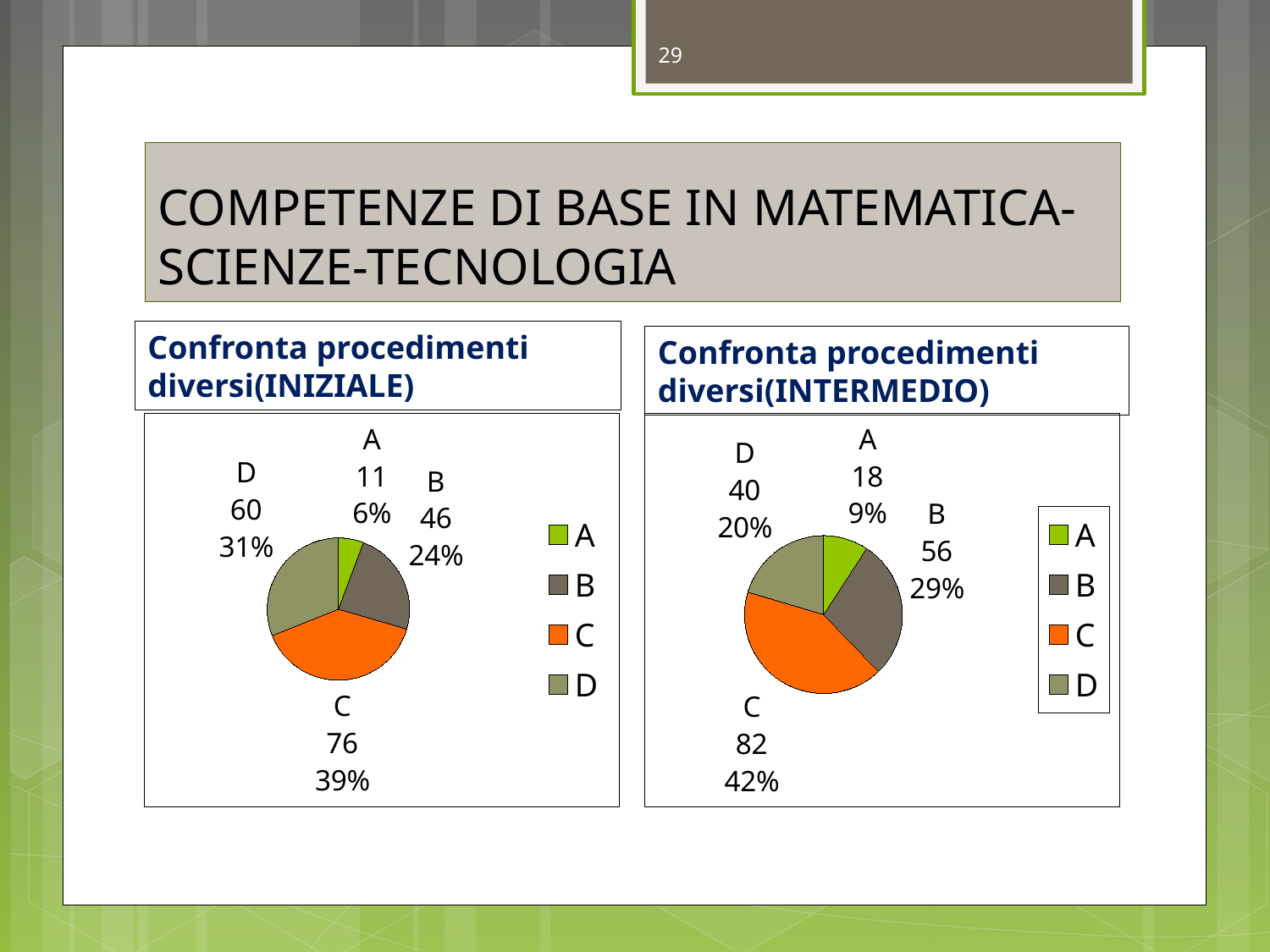
In the 'Confronta procedimenti diversi(INIZIALE)' chart, which category has the largest slice? C How many categories does the 'Confronta procedimenti diversi(INIZIALE)' chart show? 4 In the 'Confronta procedimenti diversi(INIZIALE)' chart, what is the value for C? 76 In the 'Confronta procedimenti diversi(INTERMEDIO)' chart, what is the value for B? 56 What type of chart is the 'Confronta procedimenti diversi(INTERMEDIO)' chart? Pie chart In the 'Confronta procedimenti diversi(INTERMEDIO)' chart, which is larger, the value for C or the value for D? C In the 'Confronta procedimenti diversi(INTERMEDIO)' chart, what percentage share does A have? 9% In the 'Confronta procedimenti diversi(INTERMEDIO)' chart, what colour is the slice for C? Orange In the 'Confronta procedimenti diversi(INIZIALE)' chart, what percentage share does D have? 31% In the 'Confronta procedimenti diversi(INIZIALE)' chart, what is the difference between the values for D and B? 14 How many entries does the legend of the 'Confronta procedimenti diversi(INIZIALE)' chart list? 4 In the 'Confronta procedimenti diversi(INTERMEDIO)' chart, which category has the smallest slice? A